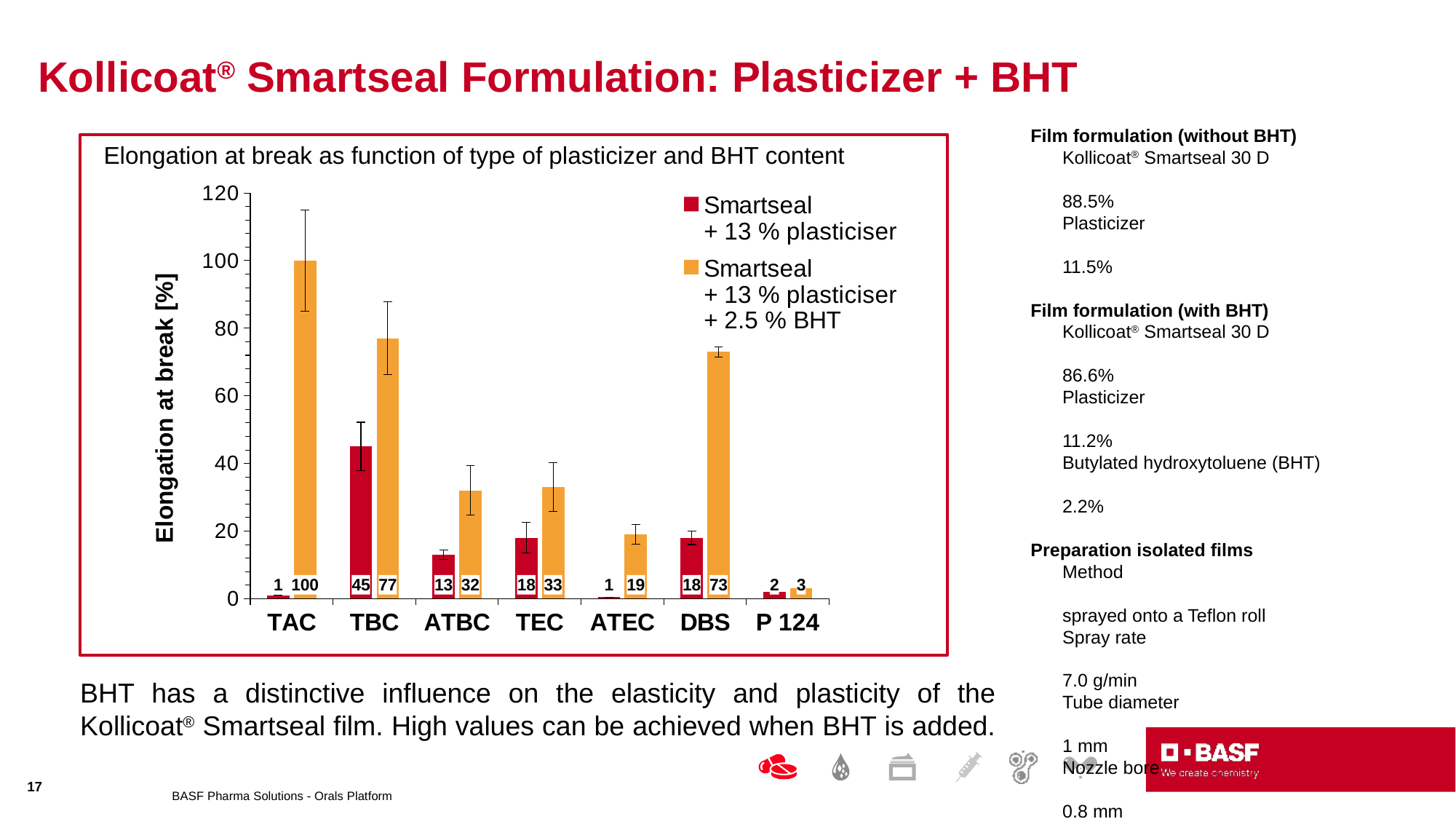
Which plasticizer has the lowest elongation at break in the Smartseal + 13 % plasticiser + 2.5 % BHT series? P 124 What is the label of the y axis of the chart? Elongation at break [%] What is the elongation at break for TAC with Smartseal + 13 % plasticiser + 2.5 % BHT? 100 Is the elongation at break for TBC with BHT greater or less than 60? greater How many series does the legend list? 2 Which is larger: the elongation at break for TEC with BHT or for ATBC with BHT? TEC with BHT What is the difference in elongation at break for TBC between the series with BHT and the series without BHT? 32 What is the elongation at break for TBC with Smartseal + 13 % plasticiser (without BHT)? 45 How many plasticizer categories are shown on the x axis? 7 Which plasticizer has the highest elongation at break in the Smartseal + 13 % plasticiser + 2.5 % BHT series? TAC What is the elongation at break for DBS with Smartseal + 13 % plasticiser + 2.5 % BHT? 73 What kind of chart is shown on the slide? Bar chart